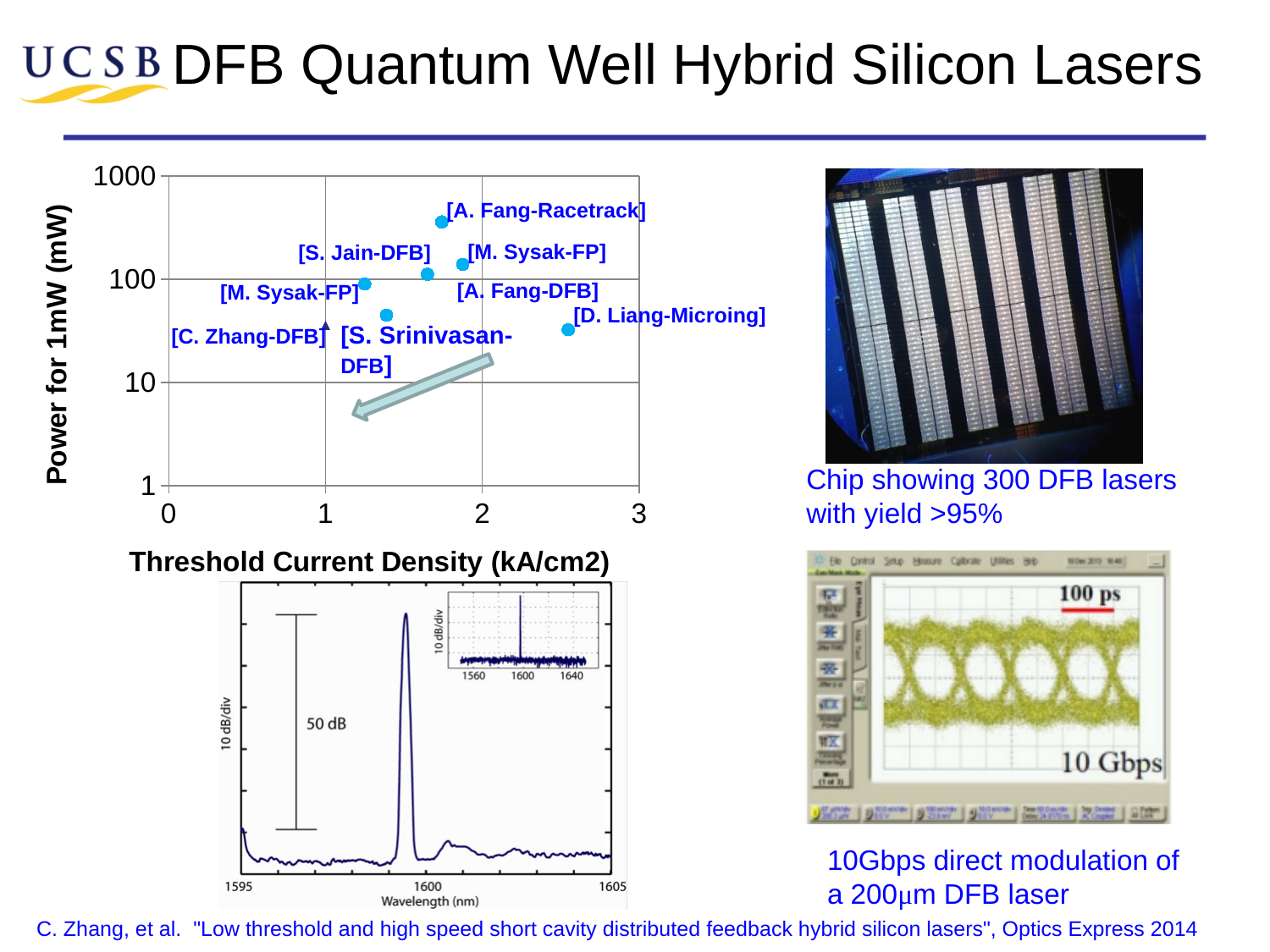
In the Power for 1mW chart, which labelled laser has the highest power? [A. Fang-Racetrack] In the Power for 1mW chart, which has the higher threshold current density, [D. Liang-Microring] or [C. Zhang-DFB]? [D. Liang-Microring] In the Power for 1mW chart, is the power for [C. Zhang-DFB] greater or less than 100? less In the wavelength spectrum chart at the bottom left, what side-mode suppression value is annotated on the plot? 50 dB In the Power for 1mW chart, is the threshold current density for [D. Liang-Microring] greater or less than 2? greater In the Power for 1mW chart, is the power for [A. Fang-Racetrack] greater or less than 100? greater In the Power for 1mW chart, which labelled laser has the lowest threshold current density? [C. Zhang-DFB] In the Power for 1mW chart, which labelled laser has the highest threshold current density? [D. Liang-Microring] What is the y-axis title of the scatter chart on the left of the slide? Power for 1mW (mW) In the Power for 1mW chart, which has the higher power, [A. Fang-Racetrack] or [D. Liang-Microring]? [A. Fang-Racetrack] What kind of chart is the plot of Power for 1mW versus Threshold Current Density? Scatter chart